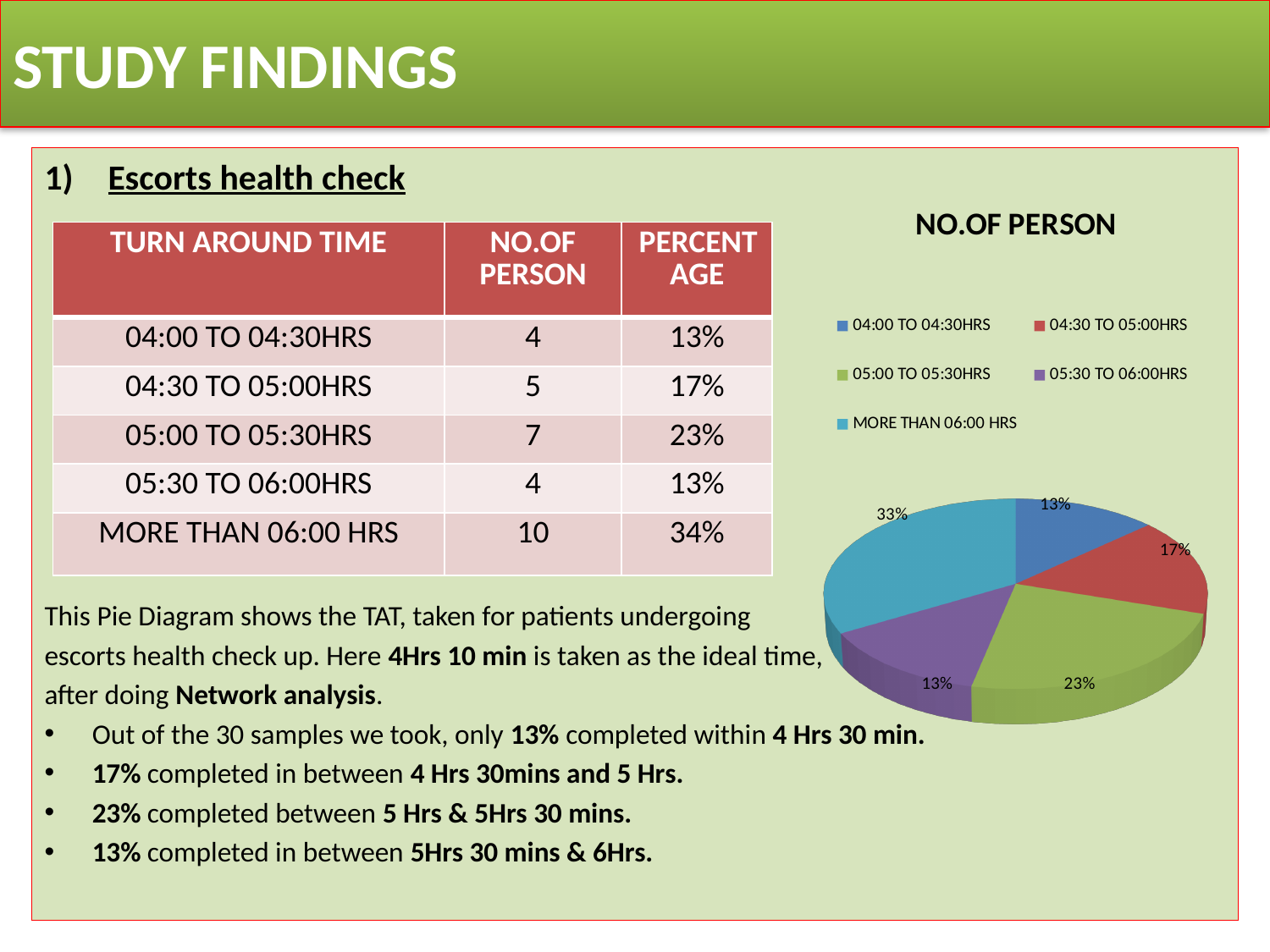
What percentage label is shown on the pie slice for MORE THAN 06:00 HRS? 33% Which colour represents 05:30 TO 06:00HRS in the pie chart? Purple How many slices does the pie chart have? 5 What type of chart is shown on the slide? Pie chart What percentage label is shown on the pie slice for 05:00 TO 05:30HRS? 23% How many entries does the chart legend list? 5 What is the difference in percentage points between the MORE THAN 06:00 HRS slice and the 05:00 TO 05:30HRS slice? 10% Which slice is larger in the pie chart: 05:00 TO 05:30HRS or 04:30 TO 05:00HRS? 05:00 TO 05:30HRS What percentage label is shown on the pie slice for 04:30 TO 05:00HRS? 17% What is the title of the chart? NO.OF PERSON Which category has the largest slice in the pie chart? MORE THAN 06:00 HRS What share of the pie does the 04:00 TO 04:30HRS slice represent? 13%